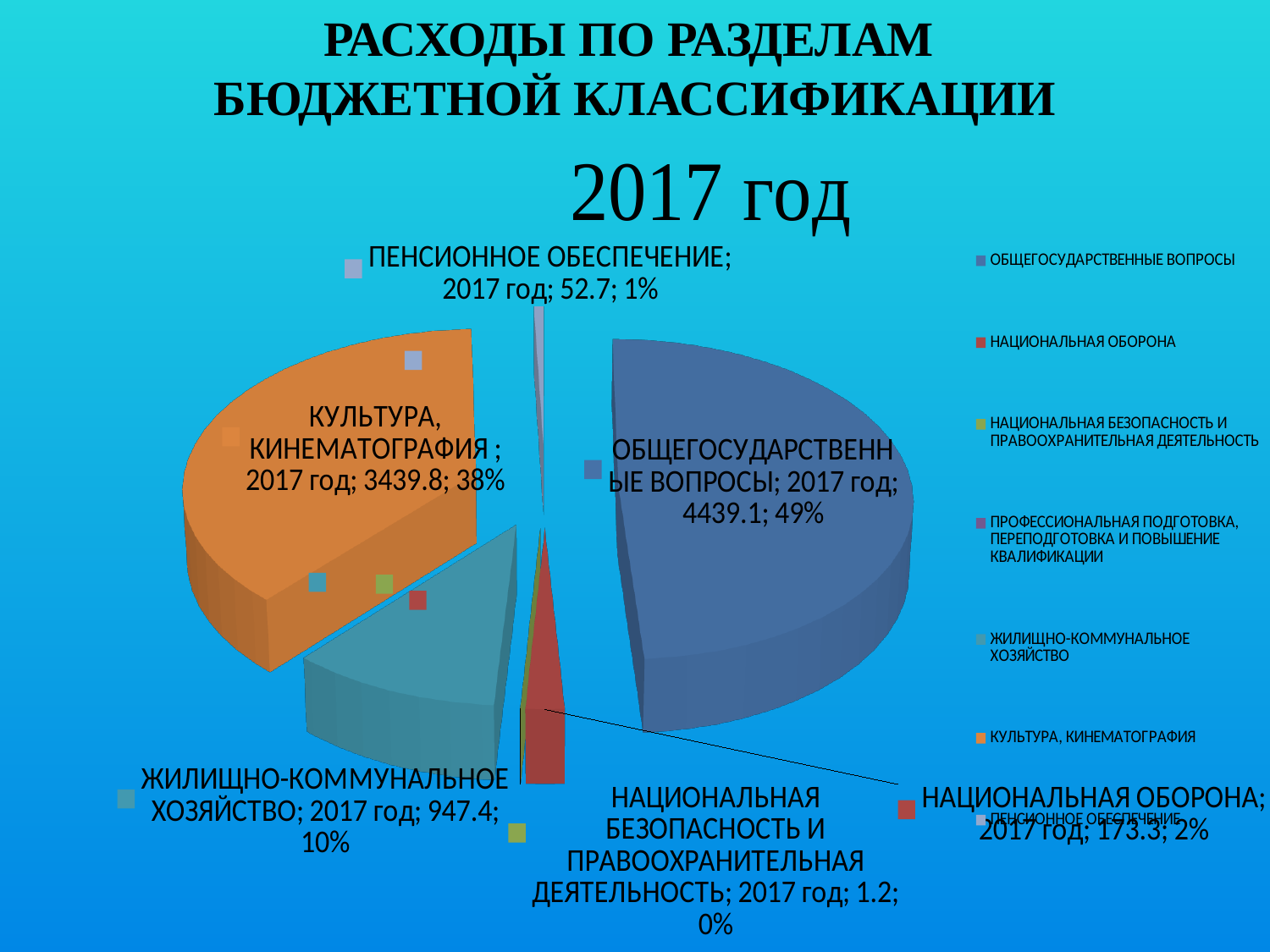
How many entries does the legend of the pie chart list? 7 Which is larger in the 2017 год pie chart: ЖИЛИЩНО-КОММУНАЛЬНОЕ ХОЗЯЙСТВО or НАЦИОНАЛЬНАЯ ОБОРОНА? ЖИЛИЩНО-КОММУНАЛЬНОЕ ХОЗЯЙСТВО Which category has the largest slice in the 2017 год pie chart? ОБЩЕГОСУДАРСТВЕННЫЕ ВОПРОСЫ What is the value for ПЕНСИОННОЕ ОБЕСПЕЧЕНИЕ in the 2017 год pie chart? 52.7 What type of chart is shown on the slide? pie chart What is the value for КУЛЬТУРА, КИНЕМАТОГРАФИЯ in the 2017 год pie chart? 3439.8 What is the value for НАЦИОНАЛЬНАЯ ОБОРОНА in the 2017 год pie chart? 173.3 What share of the 2017 год pie does ОБЩЕГОСУДАРСТВЕННЫЕ ВОПРОСЫ represent? 49% What is the value for ОБЩЕГОСУДАРСТВЕННЫЕ ВОПРОСЫ in the 2017 год pie chart? 4439.1 What share of the 2017 год pie does КУЛЬТУРА, КИНЕМАТОГРАФИЯ represent? 38% What is the difference between the values for ОБЩЕГОСУДАРСТВЕННЫЕ ВОПРОСЫ and КУЛЬТУРА, КИНЕМАТОГРАФИЯ in the 2017 год pie chart? 999.3 What is the value for ЖИЛИЩНО-КОММУНАЛЬНОЕ ХОЗЯЙСТВО in the 2017 год pie chart? 947.4